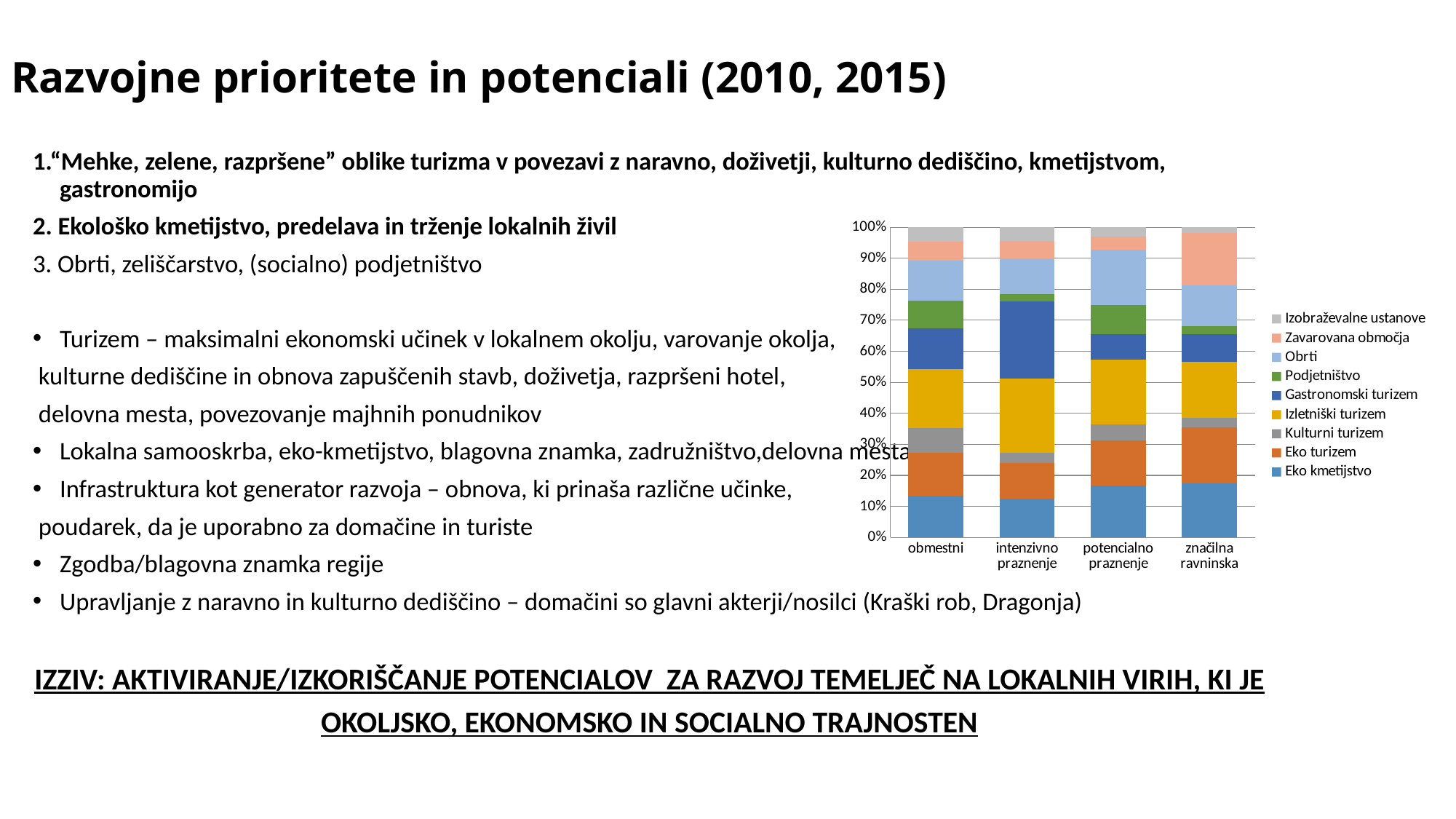
Which series is listed first (at the top) in the chart legend? Izobraževalne ustanove In which category does Zavarovana območja take the largest share of the bar? značilna ravninska Is the Eko kmetijstvo share for obmestni greater or less than 20%? less What kind of chart is shown on the slide? Stacked bar chart In which category does Gastronomski turizem take the largest share of the bar? intenzivno praznenje Which series is at the bottom of each stacked bar in the chart? Eko kmetijstvo How many categories are shown on the x axis of the chart? 4 How many series does the chart legend list? 9 What is the total height of the obmestni stacked bar? 100% Which category has the larger Eko turizem share, značilna ravninska or intenzivno praznenje? značilna ravninska In which category does Kulturni turizem take the largest share of the bar? obmestni